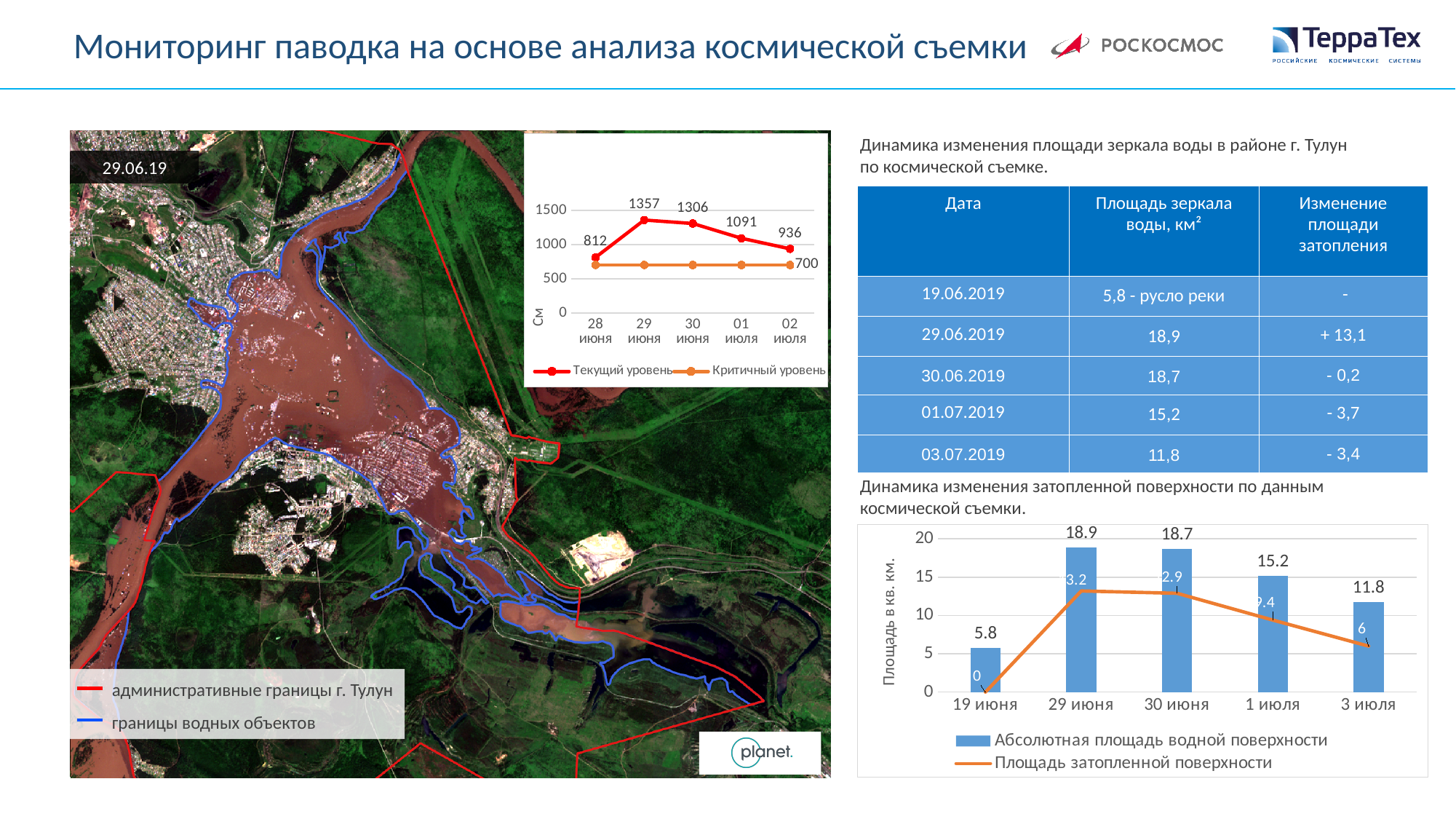
In the water level line chart on the satellite image, what is the value of Текущий уровень on 02 июля? 936 In the bottom-right chart (Динамика изменения затопленной поверхности), on which date is Абсолютная площадь водной поверхности lowest? 19 июня In the water level line chart on the satellite image, what is the value of Текущий уровень on 29 июня? 1357 In the water level line chart on the satellite image, what is the difference between Текущий уровень on 29 июня and on 30 июня? 51 In the water level line chart on the satellite image, how many series does the legend list? 2 In the bottom-right chart (Динамика изменения затопленной поверхности), what is the value of Абсолютная площадь водной поверхности on 3 июля? 11.8 In the water level line chart on the satellite image, on which date is Текущий уровень lowest? 28 июня In the water level line chart on the satellite image, what is the value of Критичный уровень? 700 In the bottom-right chart (Динамика изменения затопленной поверхности), how many dates are shown on the x axis? 5 In the water level line chart on the satellite image, on which date is Текущий уровень highest? 29 июня In the bottom-right chart (Динамика изменения затопленной поверхности), what is the value of Абсолютная площадь водной поверхности on 29 июня? 18.9 In the bottom-right chart (Динамика изменения затопленной поверхности), what is the difference between Абсолютная площадь водной поверхности on 1 июля and on 3 июля? 3.4